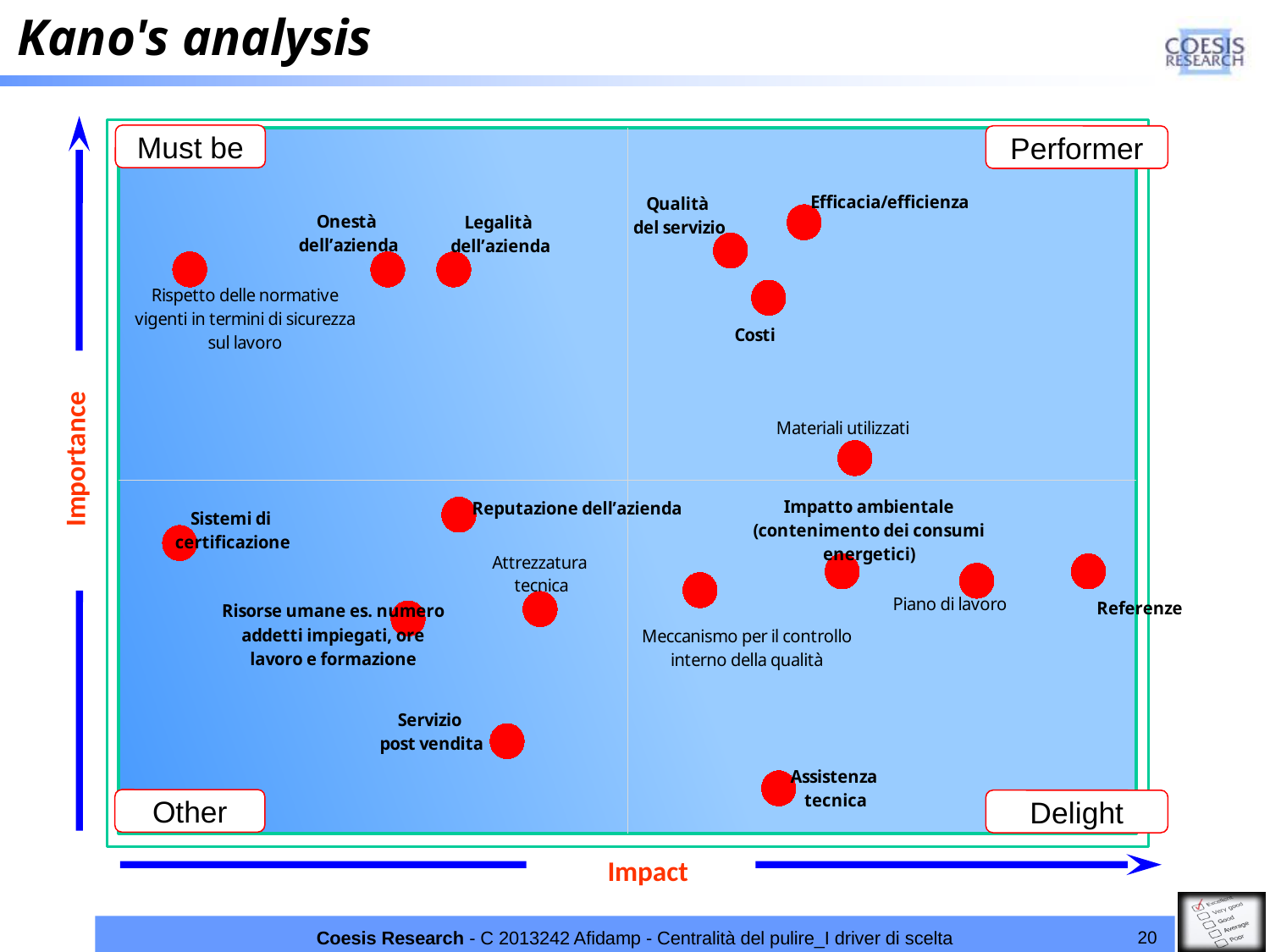
What is the title of the chart? Kano's analysis Which item has the lowest impact on the chart? Sistemi di certificazione Which has higher impact, Referenze or Piano di lavoro? Referenze Which has higher importance, Efficacia/efficienza or Costi? Efficacia/efficienza Which item has the lowest importance on the chart? Assistenza tecnica How many data points are plotted on the chart? 17 In which quadrant is Costi located? Performer Which item has the highest impact on the chart? Referenze What are the labels of the vertical and horizontal axes? Importance and Impact In which quadrant is Servizio post vendita located? Other What kind of chart is shown on the slide? scatter chart Which item has the highest importance on the chart? Efficacia/efficienza